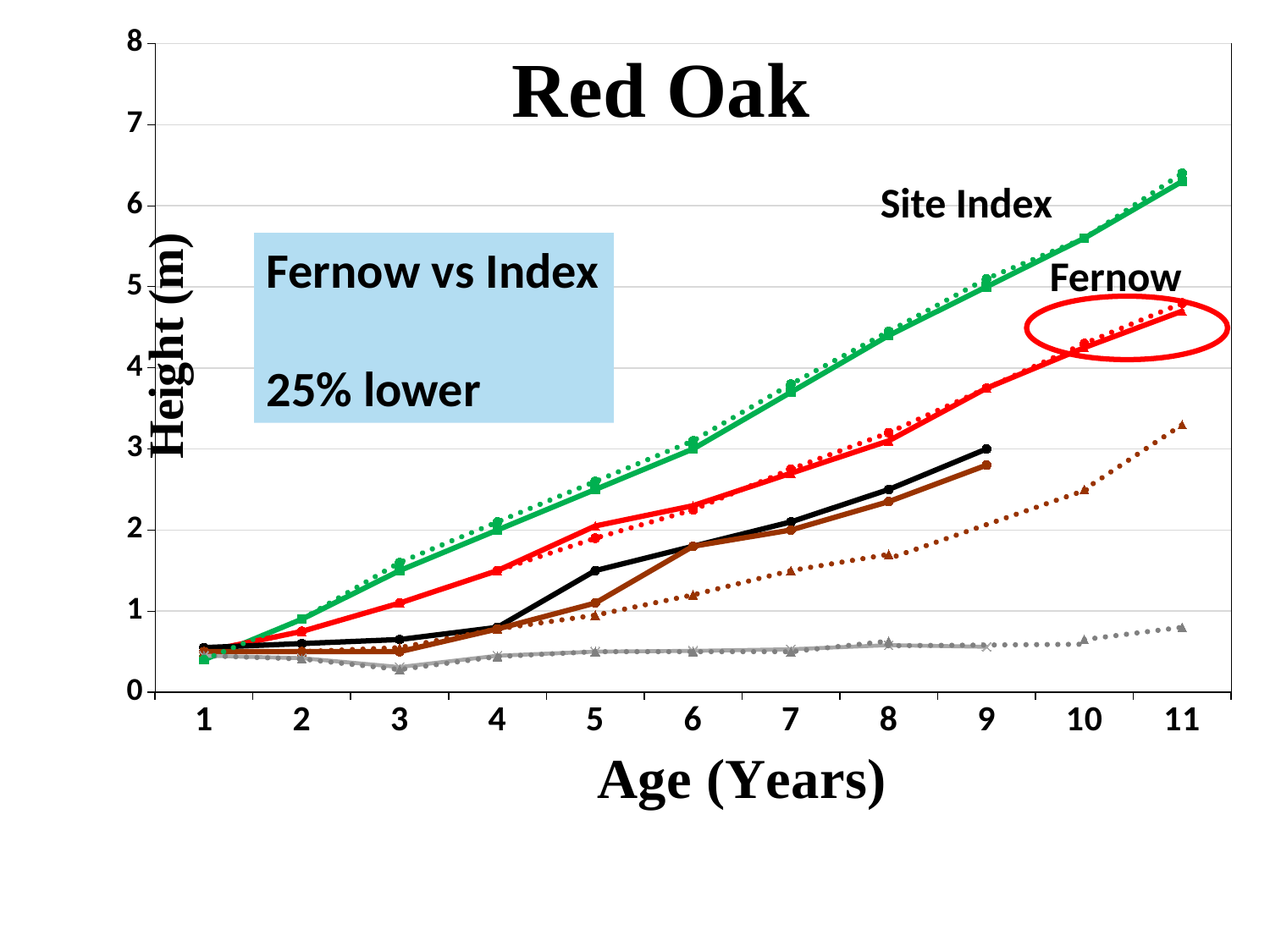
What is the title of the chart? Red Oak What kind of chart is shown on the slide? line chart Is the Site Index value at age 11 greater or less than 6? greater Is the Site Index value at age 8 greater or less than 4? greater Which labelled line is the highest at age 10, Site Index or Fernow? Site Index Does the Site Index line rise or fall as age increases? rise Is the Fernow value at age 11 greater or less than 5? less At age 11, which is higher, Site Index or Fernow? Site Index How many ages are marked along the x axis? 11 What is the label of the y axis? Height (m)